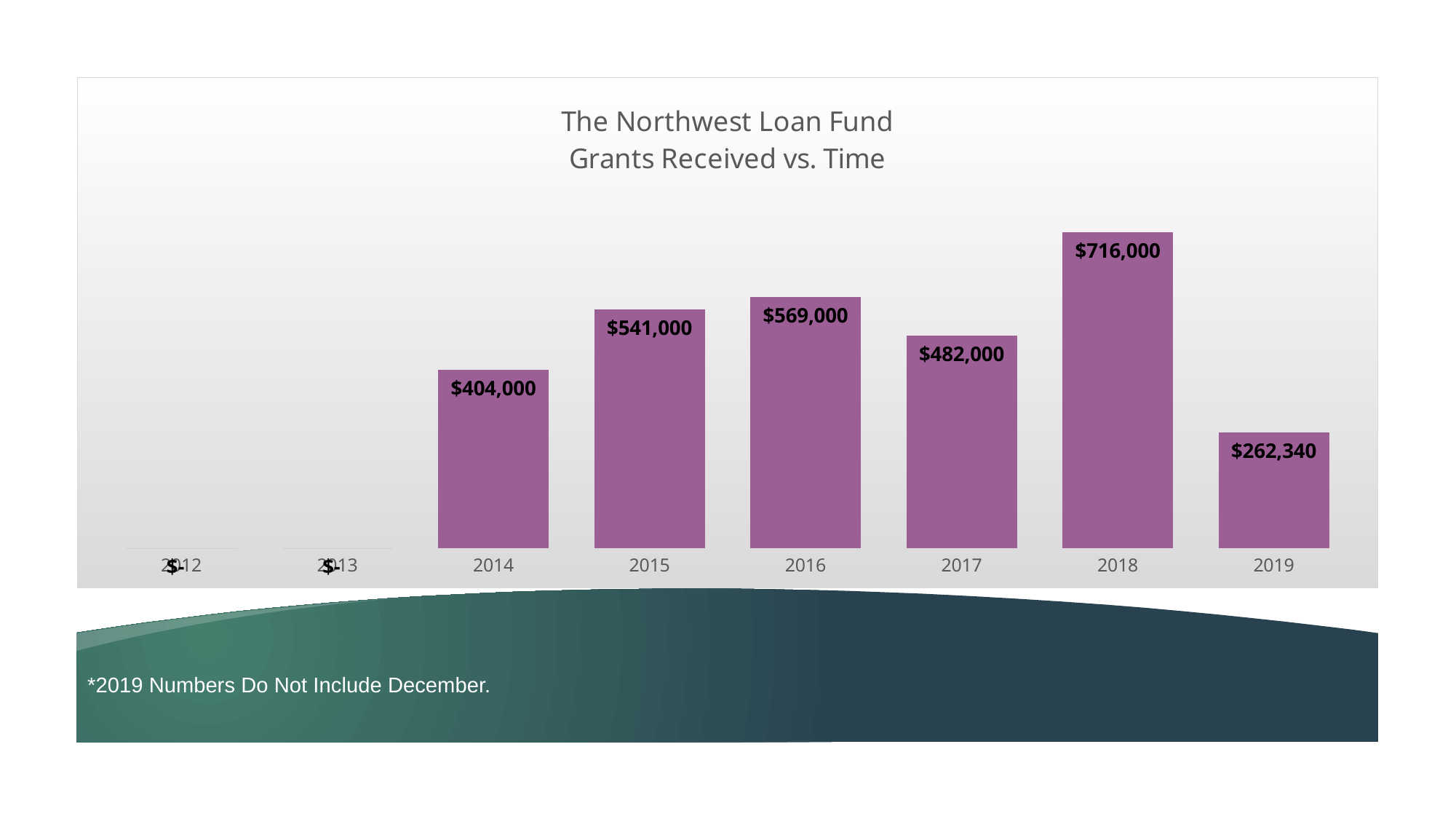
Among the years with a non-zero bar, which year has the lowest grants received? 2019 Which year has the highest grants received? 2018 How many years are shown on the x axis? 8 What value is shown for 2014? $404,000 What value is shown for 2019? $262,340 What value is shown for 2018? $716,000 What is the difference between the values for 2016 and 2015? $28,000 What is the difference between the values for 2018 and 2017? $234,000 What kind of chart is shown on the slide? bar chart What value is shown for 2017? $482,000 Which is larger, the value for 2015 or the value for 2017? 2015 What is the title of the chart? The Northwest Loan Fund Grants Received vs. Time